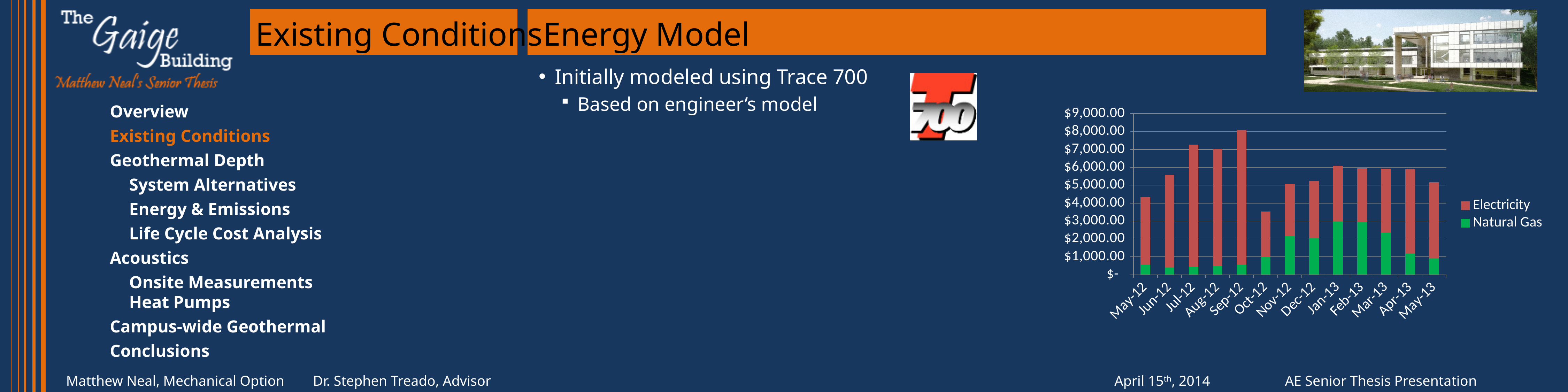
Is the Natural Gas value for May-12 greater or less than $1,000.00? less How many months are plotted along the x axis of the chart? 13 Which month has the lowest total bar in the chart? Oct-12 Is the Natural Gas value for Jan-13 greater or less than $2,000.00? greater What kind of chart is shown on the slide? Stacked bar chart Which two series are listed in the chart legend? Electricity and Natural Gas How many series does the chart legend list? 2 Which month has the highest total bar in the chart? Sep-12 Is the total bar for Sep-12 greater or less than $7,000.00? greater Which month has the larger total bar, Jul-12 or Jun-12? Jul-12 Which colour represents Electricity in the chart? Red